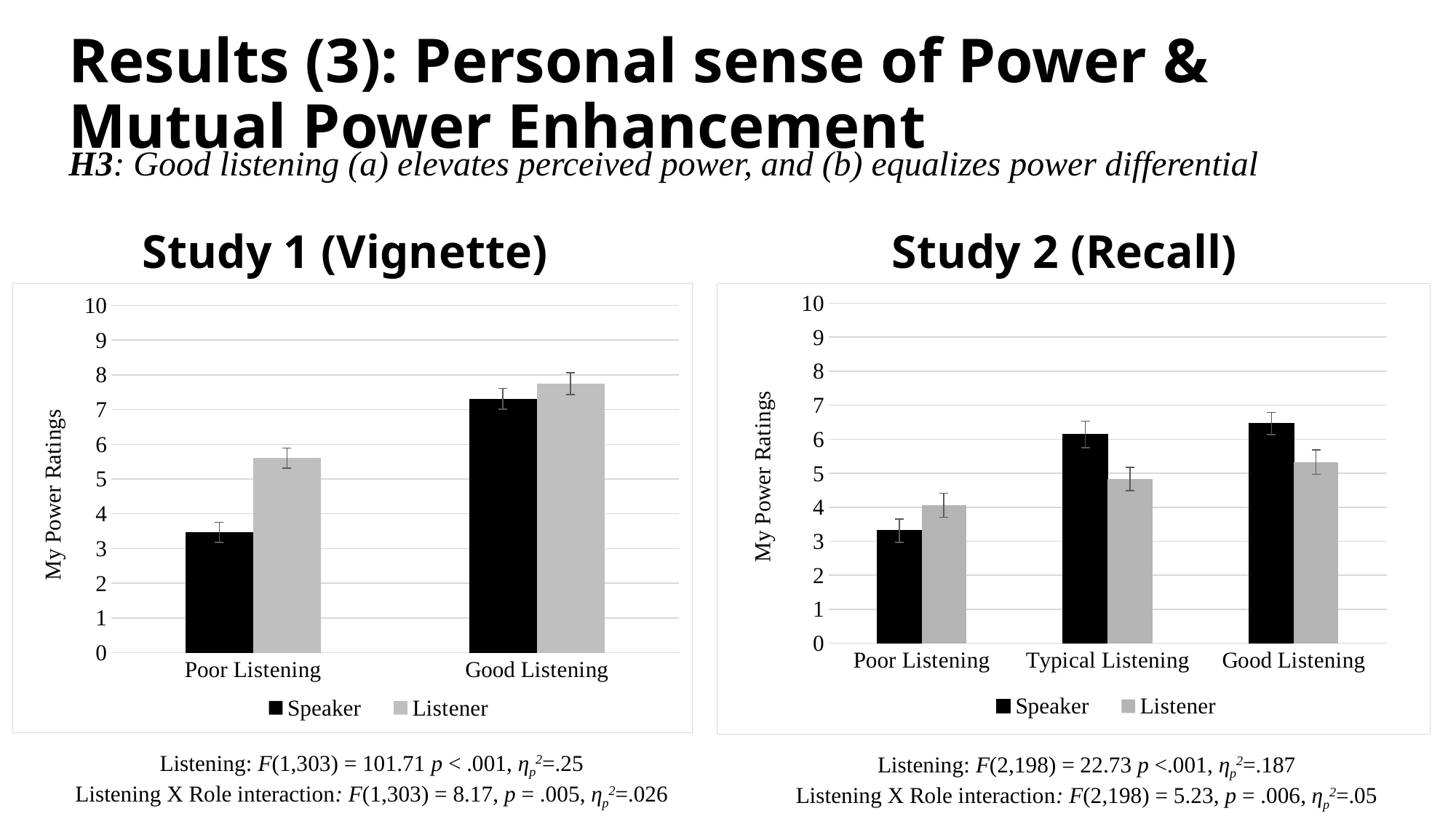
In the Study 1 (Vignette) chart, is the Listener value for Poor Listening greater or less than 5? greater In the Study 2 (Recall) chart, what is the label of the y axis? My Power Ratings In the Study 2 (Recall) chart, which is larger for Typical Listening, the Speaker value or the Listener value? Speaker In the Study 1 (Vignette) chart, is the Speaker value for Good Listening greater or less than 7? greater In the Study 2 (Recall) chart, how many listening categories are shown on the x axis? 3 What type of chart is shown under Study 1 (Vignette)? bar chart In the Study 1 (Vignette) chart, is the Speaker value for Poor Listening greater or less than 4? less In the Study 2 (Recall) chart, which listening category has the lowest Listener value? Poor Listening In the Study 1 (Vignette) chart, which is larger for Poor Listening, the Speaker value or the Listener value? Listener In the Study 2 (Recall) chart, which listening category has the highest Speaker value? Good Listening In the Study 1 (Vignette) chart, how many series does the legend list? 2